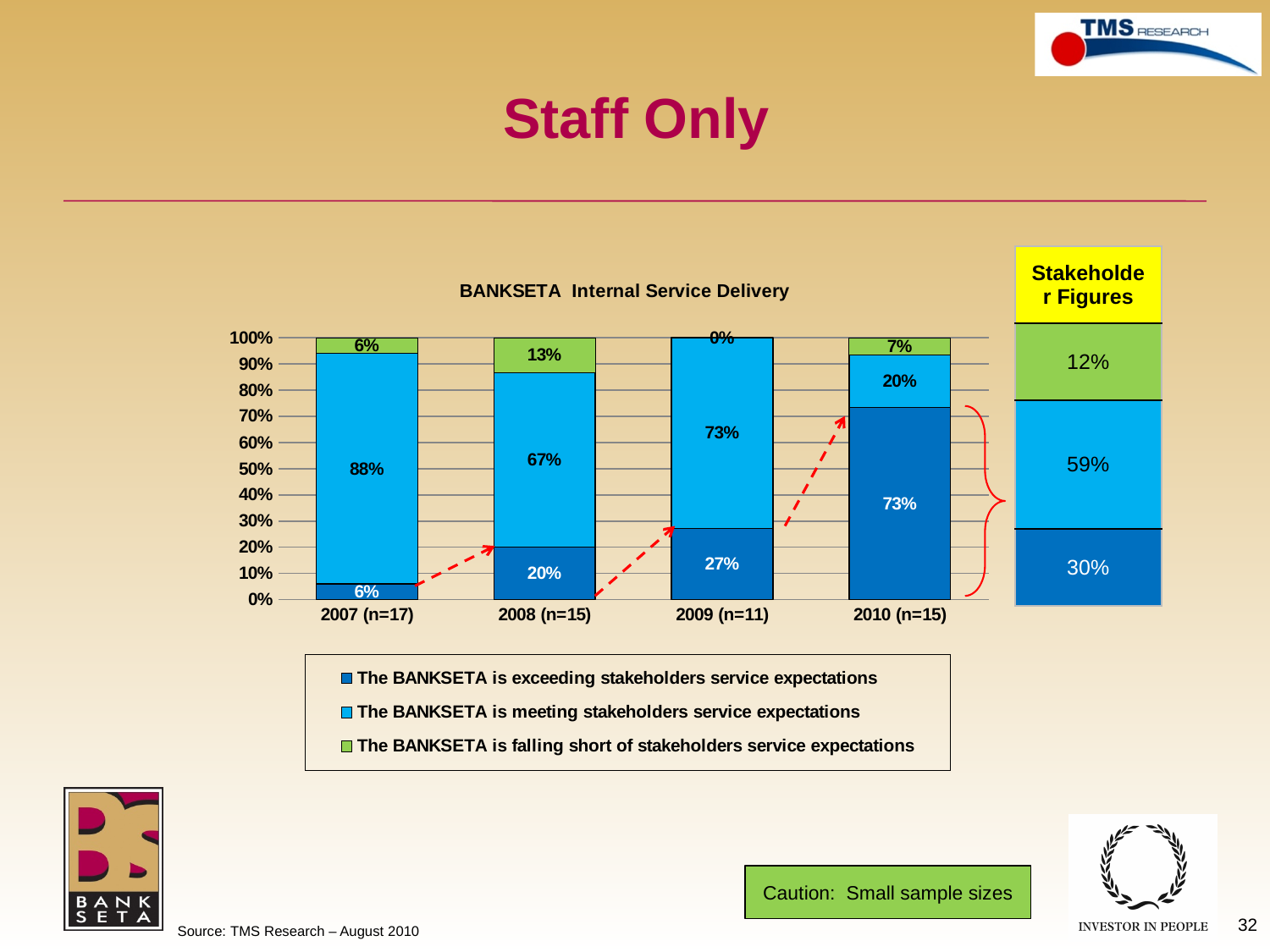
In the BANKSETA Internal Service Delivery chart, which year has the lowest percentage for 'The BANKSETA is falling short of stakeholders service expectations'? 2009 (n=11) In the 'Stakeholder Figures' bar to the right of the chart, what percentage is shown in the dark blue segment? 30% What type of chart is shown under the title 'BANKSETA Internal Service Delivery'? Stacked bar chart In the BANKSETA Internal Service Delivery chart, is the 'meeting stakeholders service expectations' percentage larger in 2008 (n=15) or in 2009 (n=11)? 2009 (n=11) In the BANKSETA Internal Service Delivery chart, what is the difference between the 'exceeding' percentage in 2010 (n=15) and in 2009 (n=11)? 46% In the BANKSETA Internal Service Delivery chart, what percentage of staff in 2007 (n=17) said the BANKSETA is meeting stakeholders service expectations? 88% In the BANKSETA Internal Service Delivery chart, what percentage of staff in 2008 (n=15) said the BANKSETA is falling short of stakeholders service expectations? 13% How many year categories are shown on the x axis of the BANKSETA Internal Service Delivery chart? 4 In the BANKSETA Internal Service Delivery chart, which year has the highest percentage for 'The BANKSETA is exceeding stakeholders service expectations'? 2010 (n=15) In the BANKSETA Internal Service Delivery chart, what percentage of staff in 2010 (n=15) said the BANKSETA is exceeding stakeholders service expectations? 73% How many series does the legend of the BANKSETA Internal Service Delivery chart list? 3 In the BANKSETA Internal Service Delivery chart, does the 'exceeding stakeholders service expectations' percentage rise or fall from 2007 to 2010? Rise